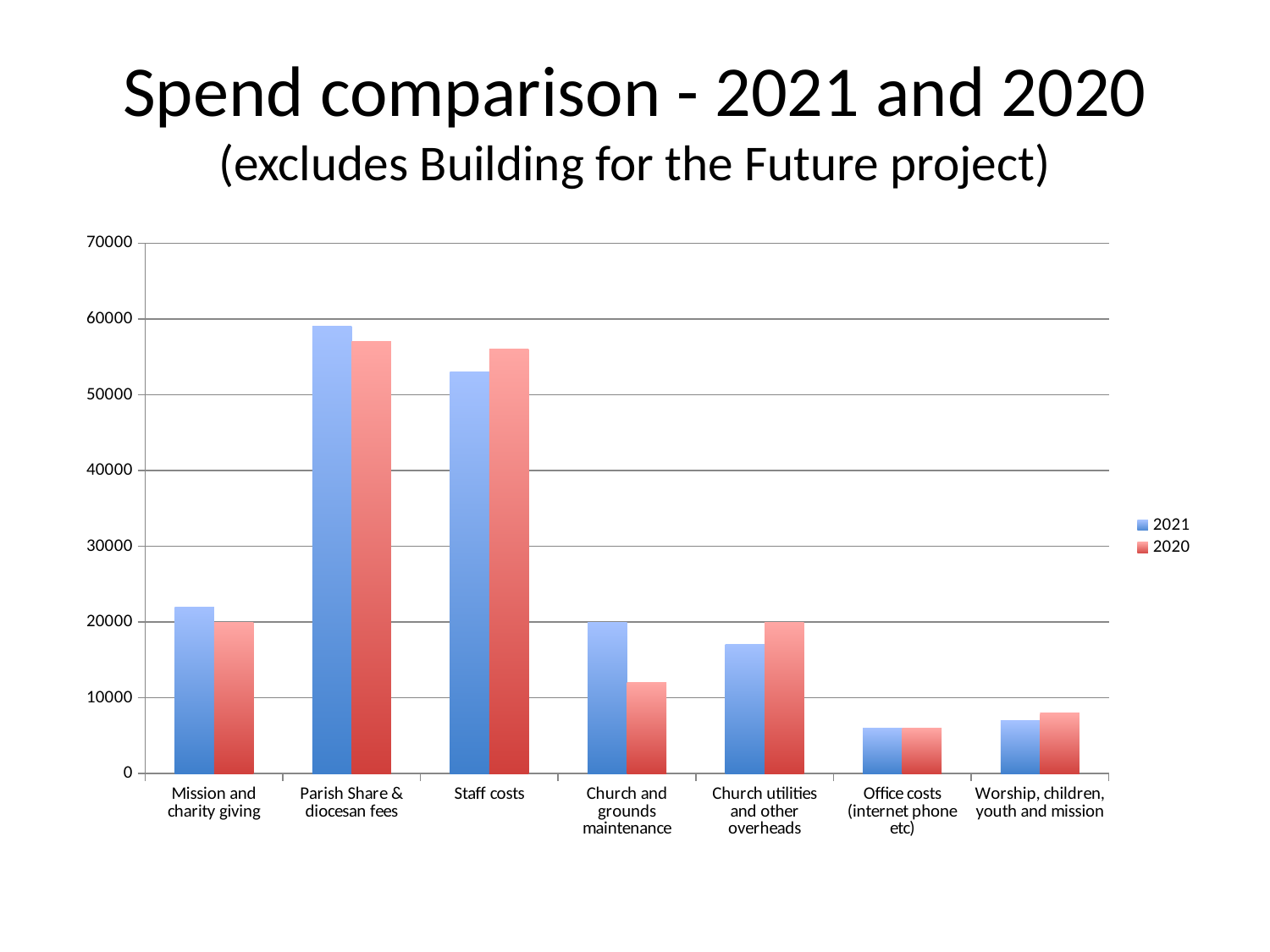
For Church and grounds maintenance, which year had the larger spend, 2021 or 2020? 2021 What are the two entries in the chart legend? 2021 and 2020 For Staff costs, which year had the larger spend, 2021 or 2020? 2020 Is the 2021 value for Parish Share & diocesan fees greater or less than 50000? greater Is the 2021 value for Church utilities and other overheads greater or less than 20000? less How many spending categories are shown on the x axis? 7 Which category has the lowest 2020 spend? Office costs (internet phone etc) What kind of chart is shown on the slide? bar chart Which category has the highest 2021 spend? Parish Share & diocesan fees Is the 2020 value for Church and grounds maintenance greater or less than 20000? less How many series does the legend list? 2 What is the 2021 value for Church and grounds maintenance? 20000